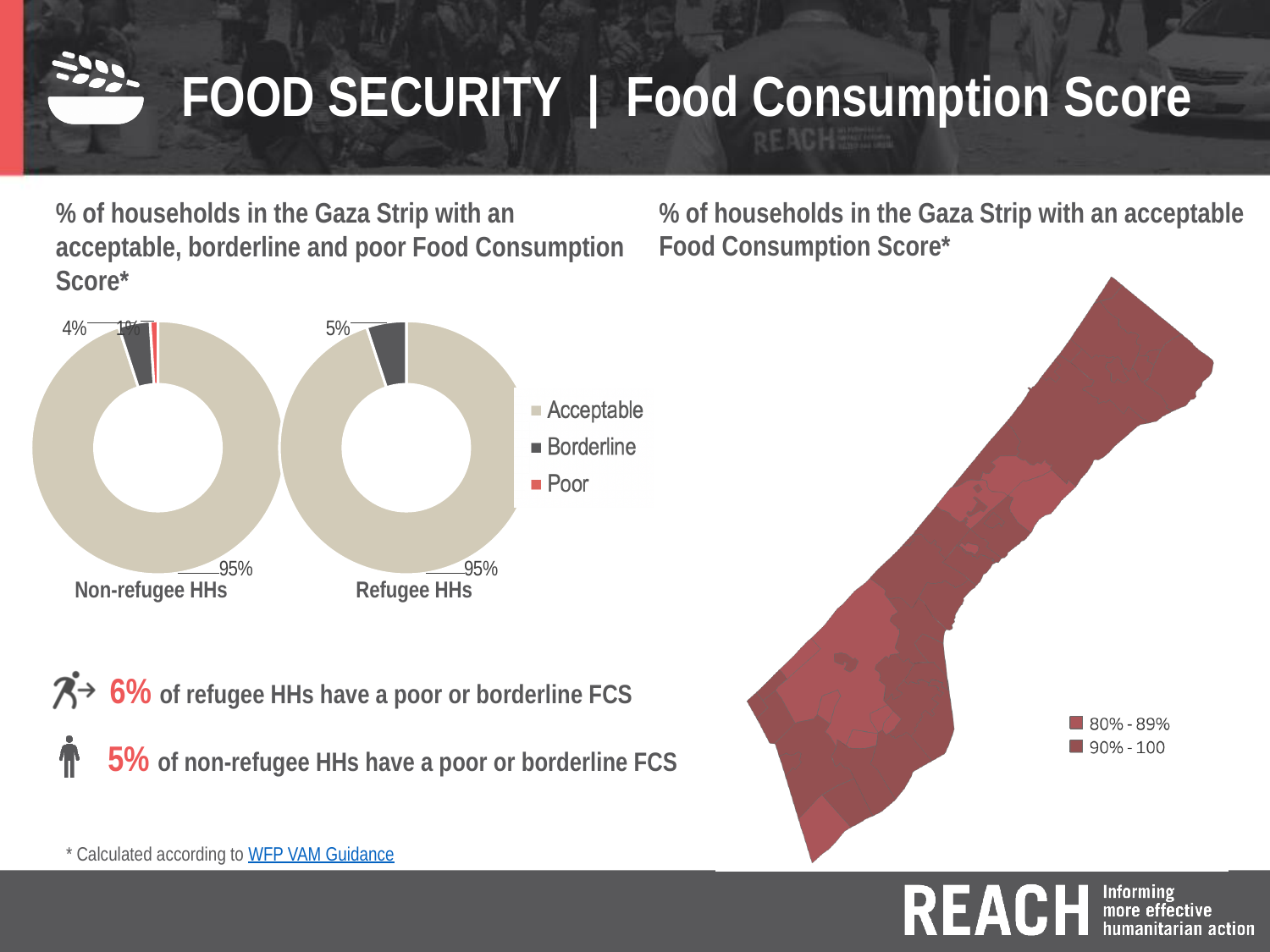
What two ranges does the legend of the Gaza Strip map show? 80% - 89% and 90% - 100 What is the difference between the Borderline share for Refugee HHs and for Non-refugee HHs? 1% What colour represents the Acceptable category in the donut charts? beige How many donut charts are shown on the left side of the slide? 2 Which group has the larger Borderline share, Non-refugee HHs or Refugee HHs? Refugee HHs In the Non-refugee HHs chart, what percentage of households have a Borderline Food Consumption Score? 4% In the Non-refugee HHs chart, what percentage of households have an Acceptable Food Consumption Score? 95% In the Refugee HHs chart, what percentage of households have an Acceptable Food Consumption Score? 95% In the Non-refugee HHs chart, which category has the largest share? Acceptable In the Refugee HHs chart, what percentage of households have a Borderline Food Consumption Score? 5% How many categories does the legend of the Food Consumption Score donut charts list? 3 What kind of chart is used to show the Food Consumption Score breakdown for Non-refugee HHs and Refugee HHs? pie chart (donut)